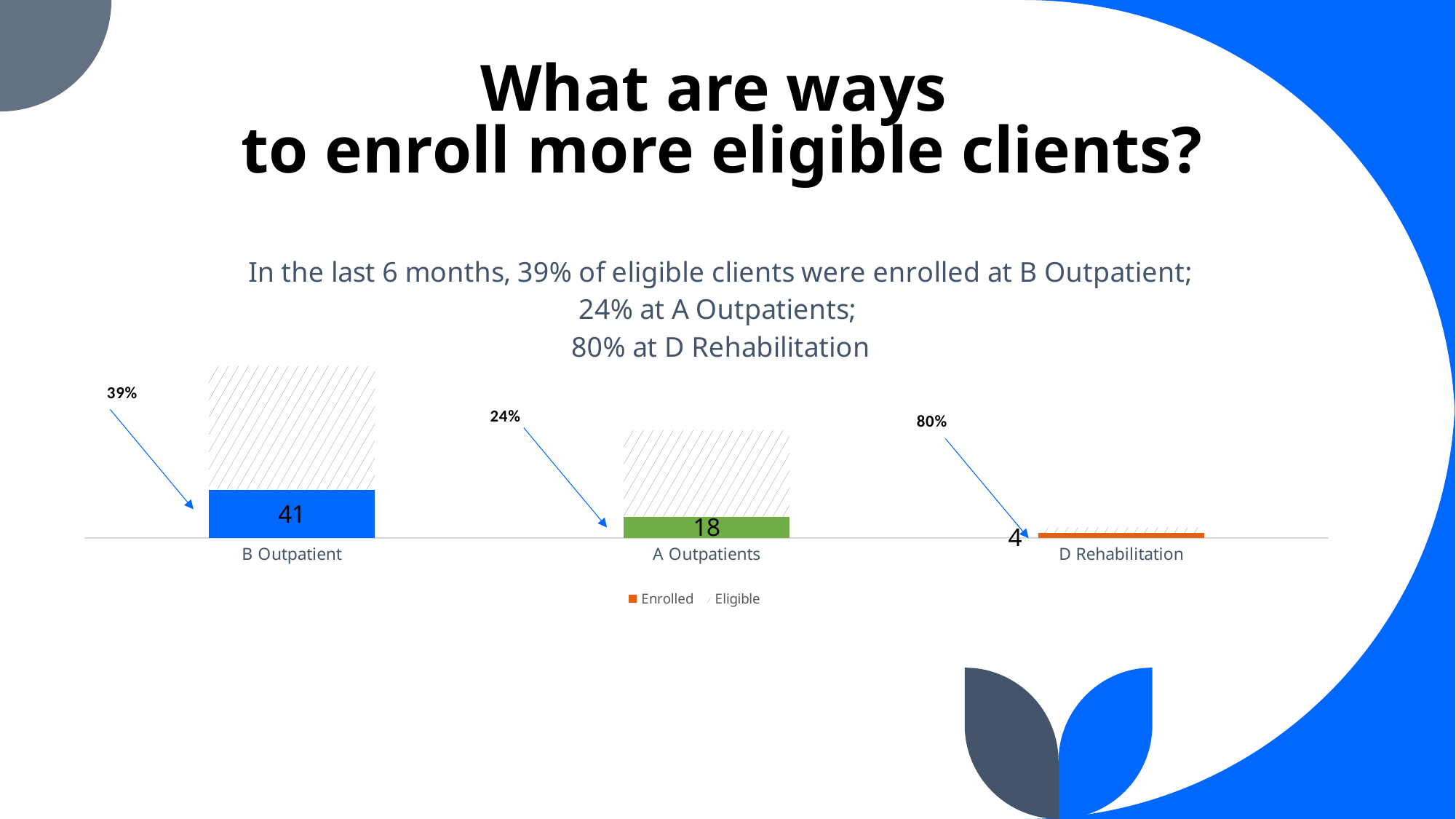
What is the Enrolled value for A Outpatients? 18 Which has a larger Enrolled value, A Outpatients or D Rehabilitation? A Outpatients How many series does the chart legend list? 2 Which category has the lowest Enrolled value? D Rehabilitation How many categories are shown on the x axis of the chart? 3 What percentage is annotated above the B Outpatient bar? 39% What is the Enrolled value for B Outpatient? 41 What is the difference between the Enrolled values for B Outpatient and A Outpatients? 23 What is the Enrolled value for D Rehabilitation? 4 What are the two entries in the chart legend? Enrolled and Eligible What kind of chart is shown on the slide? Bar chart Which category has the highest Enrolled value? B Outpatient